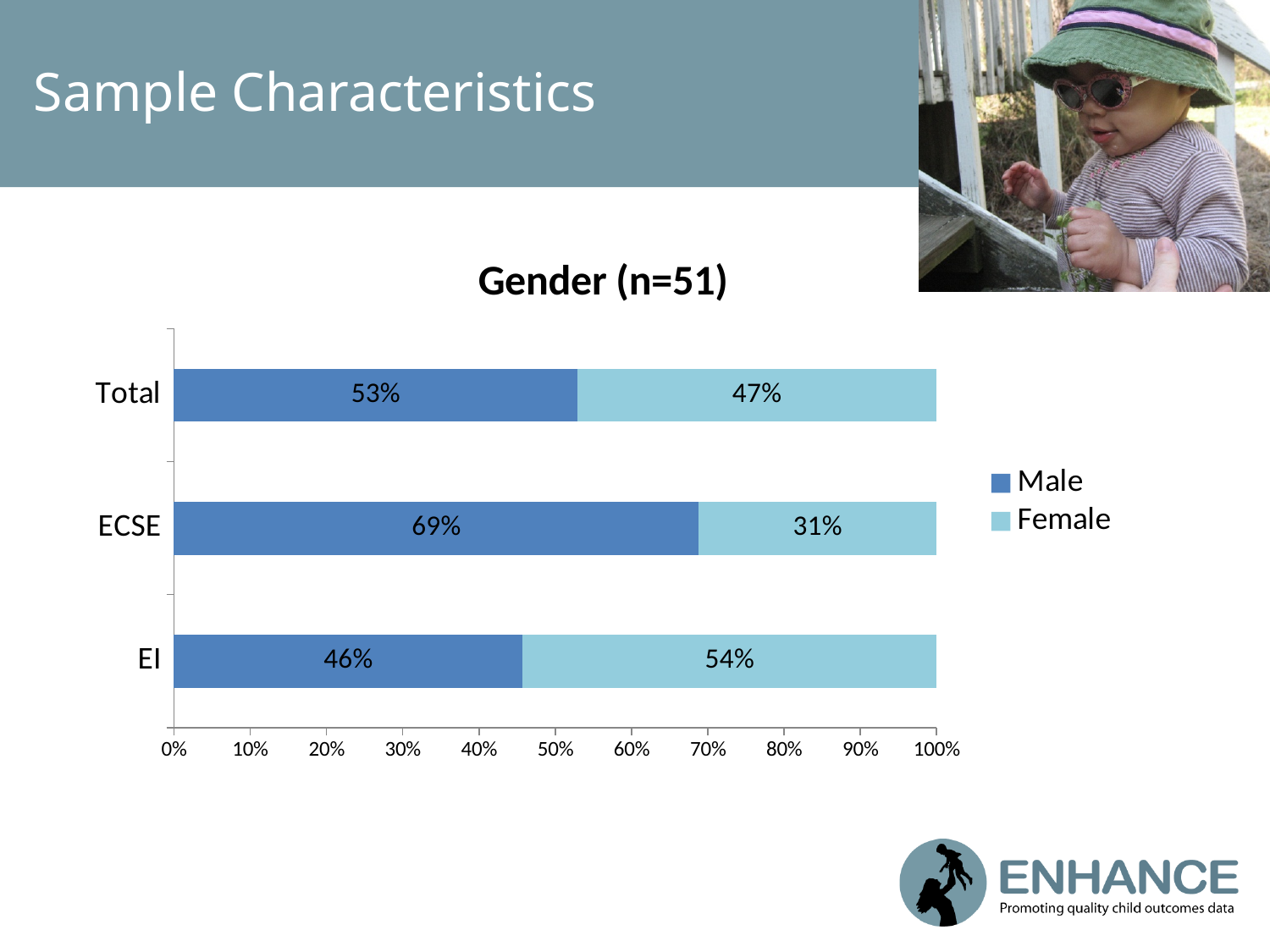
Which category has the highest Male percentage? ECSE How many series does the legend list? 2 What kind of chart is this? Stacked bar chart What is the Male value for Total? 53% What is the Male value for ECSE? 69% Is the Male percentage larger for EI or for Total? Total What is the difference between the Male and Female percentages for ECSE? 38% What is the Female value for ECSE? 31% How many categories are shown on the y axis? 3 What is the title of the chart? Gender (n=51) What is the Female value for EI? 54% Which category has the lowest Female percentage? ECSE